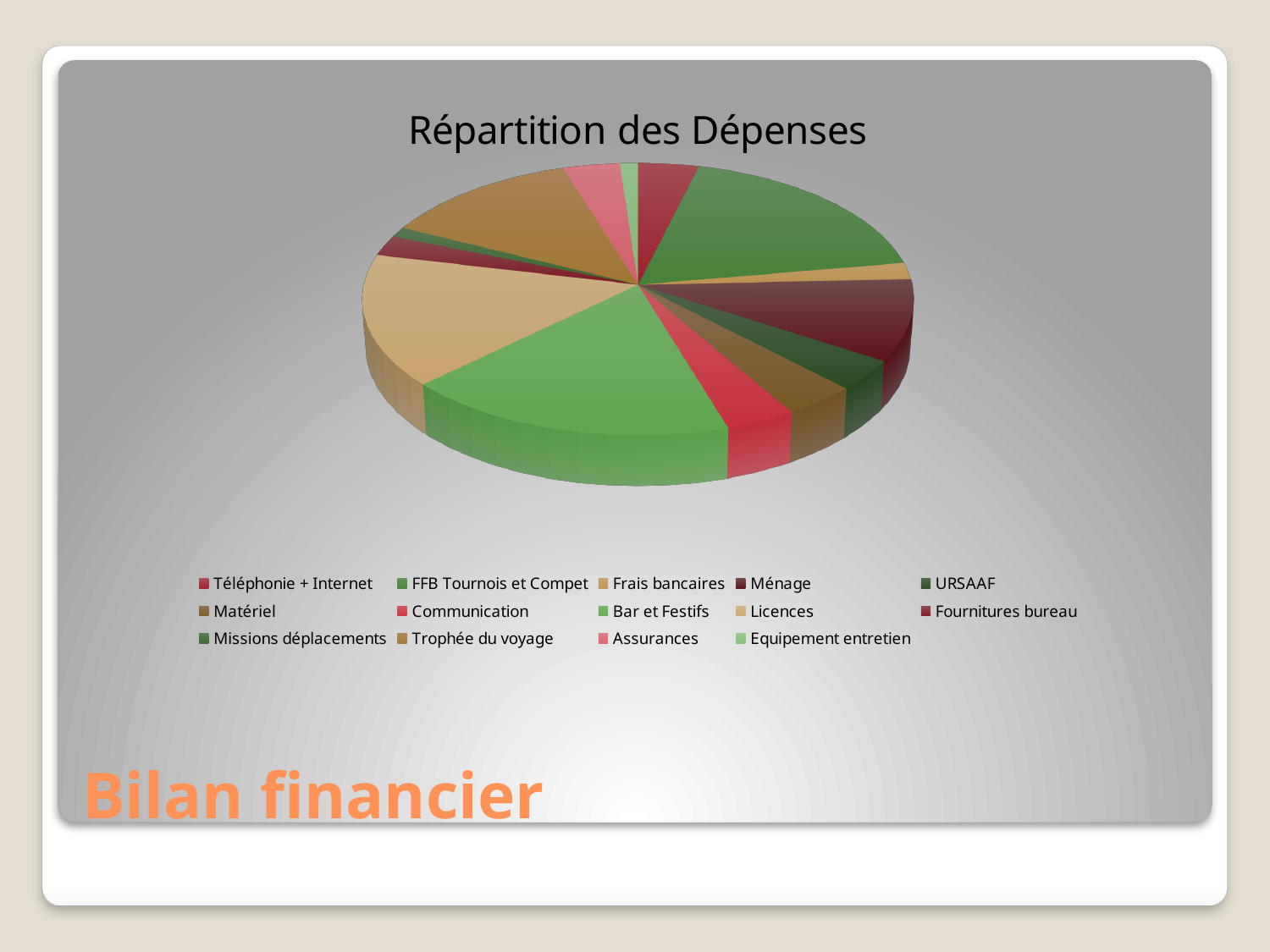
Which slice is larger, FFB Tournois et Compet or Equipement entretien? FFB Tournois et Compet Which slice is larger, Licences or Assurances? Licences What is the title of the chart? Répartition des Dépenses How many categories does the legend of the pie chart list? 14 Is the legend placed above or below the pie chart? below Which slice is larger, Bar et Festifs or Licences? Bar et Festifs What kind of chart is shown on the slide? pie chart